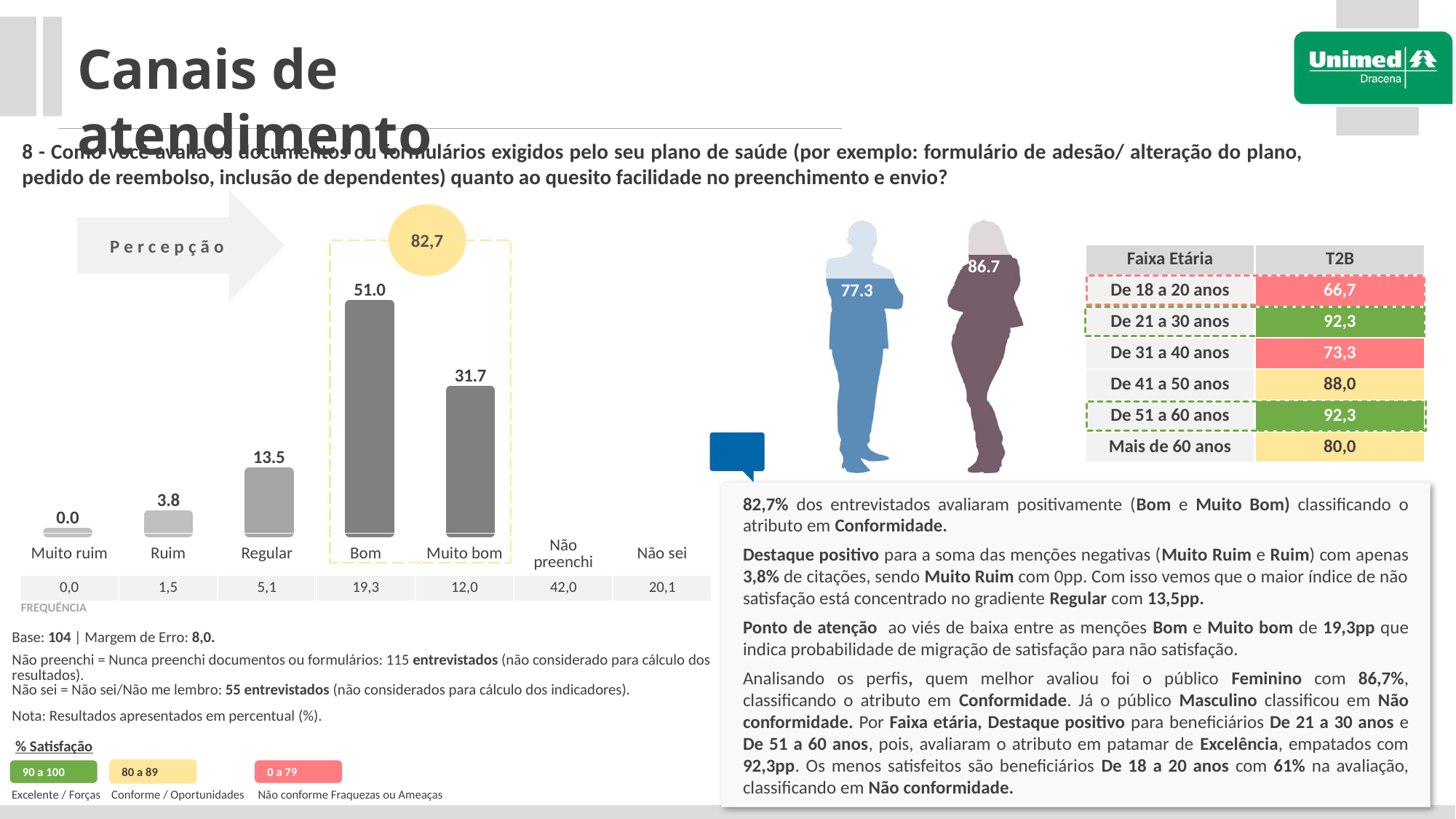
In the Faixa Etária table, which age group has the lowest T2B value? De 18 a 20 anos In the bar chart, what is the value for Bom? 51.0 In the Faixa Etária table, what is the T2B value for De 21 a 30 anos? 92,3 Which category has the lowest value in the bar chart? Muito ruim In the gender figures, what value is shown for the female silhouette? 86.7 In the bar chart, what is the value for Regular? 13.5 In the bar chart, what is the difference between the values for Bom and Muito bom? 19.3 In the bar chart, which is larger: the value for Regular or the value for Ruim? Regular What kind of chart is used to show the ratings from Muito ruim to Muito bom? bar chart What combined value is shown in the yellow circle above the Bom and Muito bom bars? 82,7 In the bar chart, what is the value for Ruim? 3.8 Which category has the highest bar in the bar chart? Bom